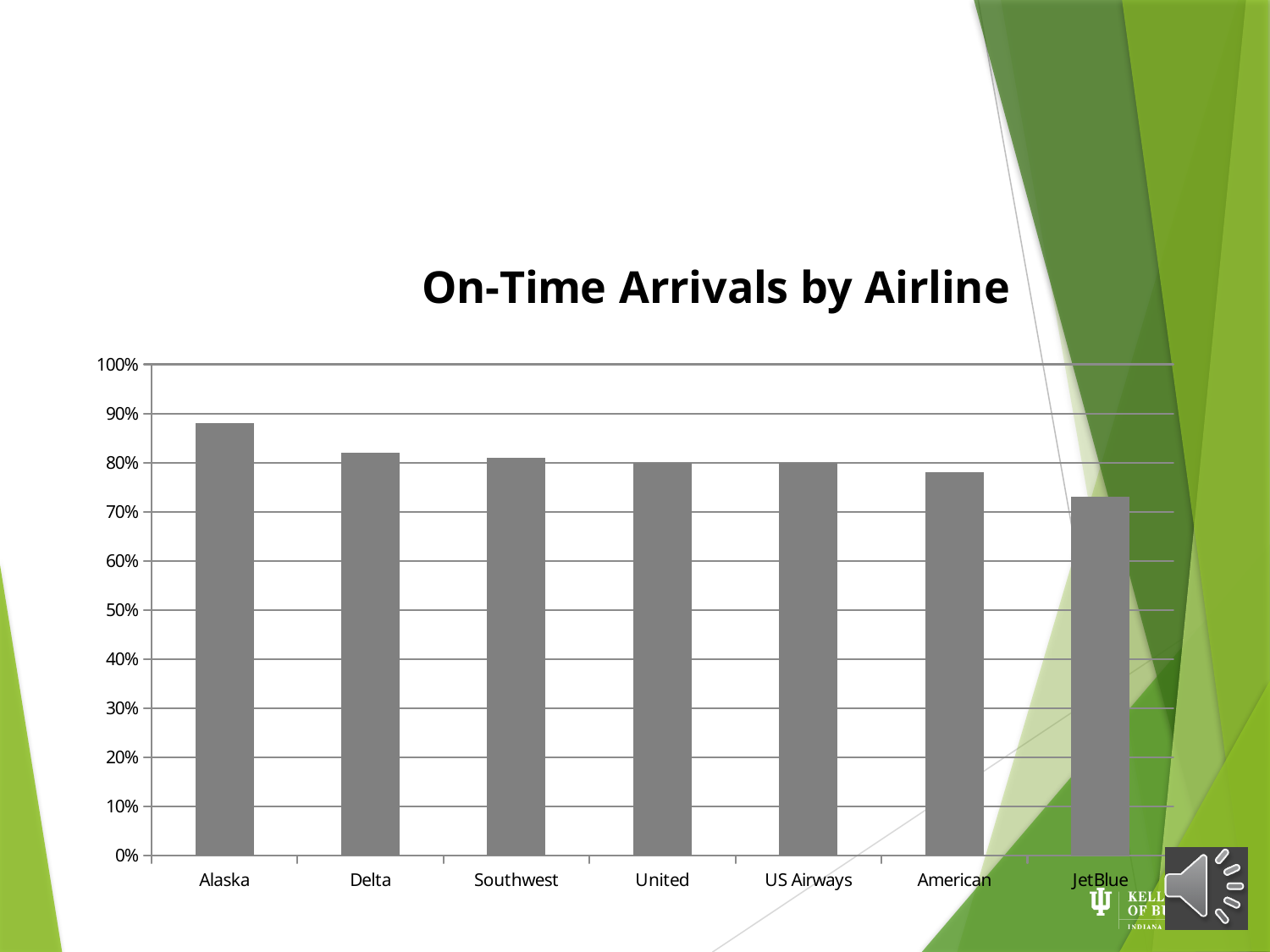
Which has a higher on-time arrival rate, Delta or American? Delta Do the bar values generally rise or fall from left to right across the airlines? fall What is the title of the chart? On-Time Arrivals by Airline What type of chart is shown on the slide? bar chart Is the value for JetBlue greater or less than 80%? less Which airline has the highest on-time arrival rate? Alaska How many airlines are shown on the x axis of the chart? 7 Which has a higher on-time arrival rate, Alaska or JetBlue? Alaska Is the value for Southwest greater or less than 90%? less Which airline has the lowest on-time arrival rate? JetBlue Is the value for Alaska greater or less than 80%? greater